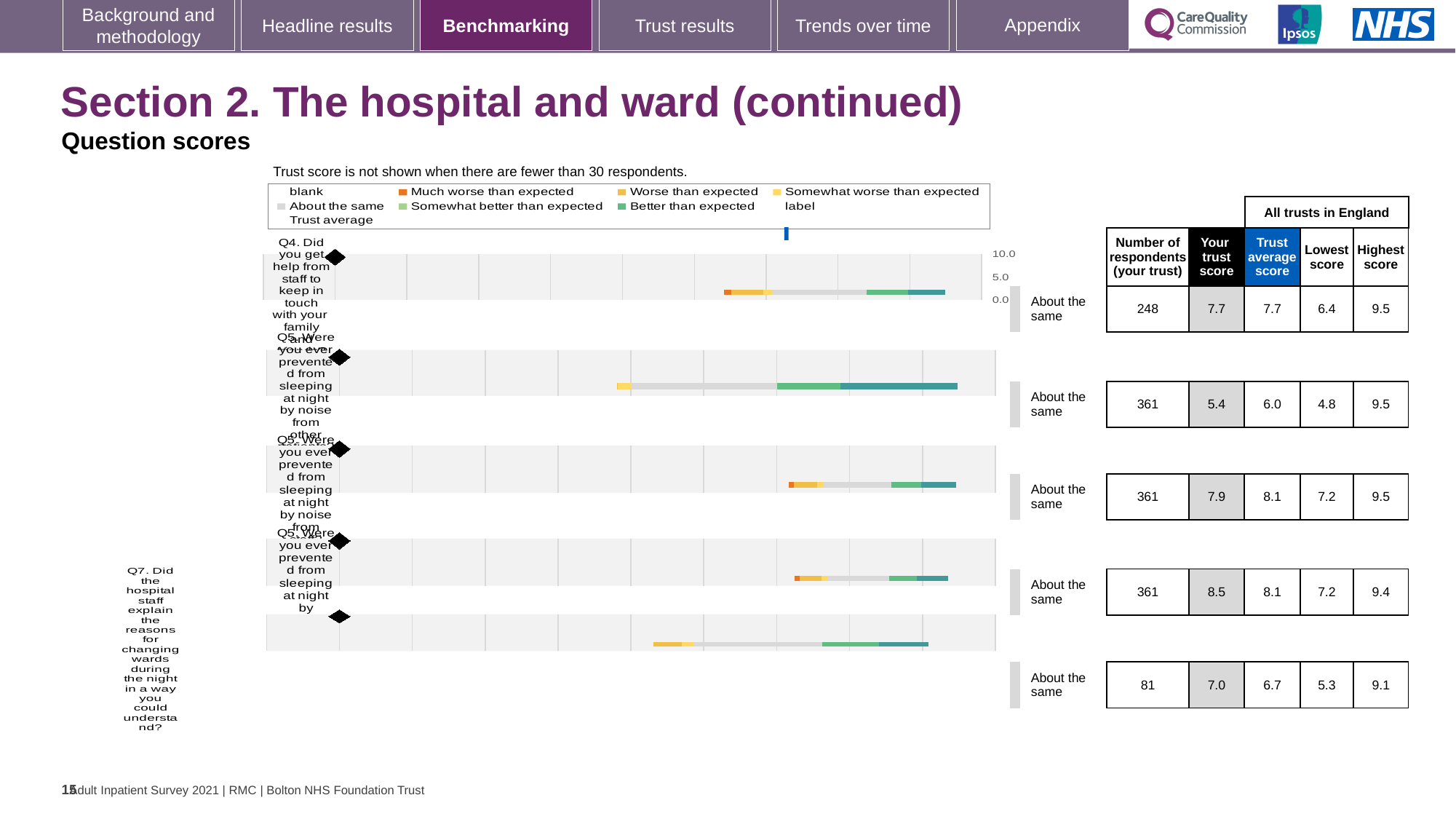
What kind of chart is used to show the question scores on this slide? bar chart What is your trust score for Q7 (explaining reasons for changing wards during the night)? 7.0 What is the maximum value shown on the chart's score axis? 10.0 How many question rows (bars) are plotted in the chart? 5 Which question row has the fewest respondents from your trust? Q7 For Q7, which is larger: your trust score or the trust average score? Your trust score According to the note above the chart, the trust score is not shown when there are fewer than how many respondents? 30 What is the difference between the highest and lowest scores across all trusts in England for Q7? 3.8 How many respondents from your trust answered Q4 (help from staff to keep in touch with family and friends)? 248 What is the lowest 'Your trust score' value shown in the table? 5.4 What is the lowest score across all trusts in England for Q7? 5.3 What is the highest score across all trusts in England for Q4? 9.5